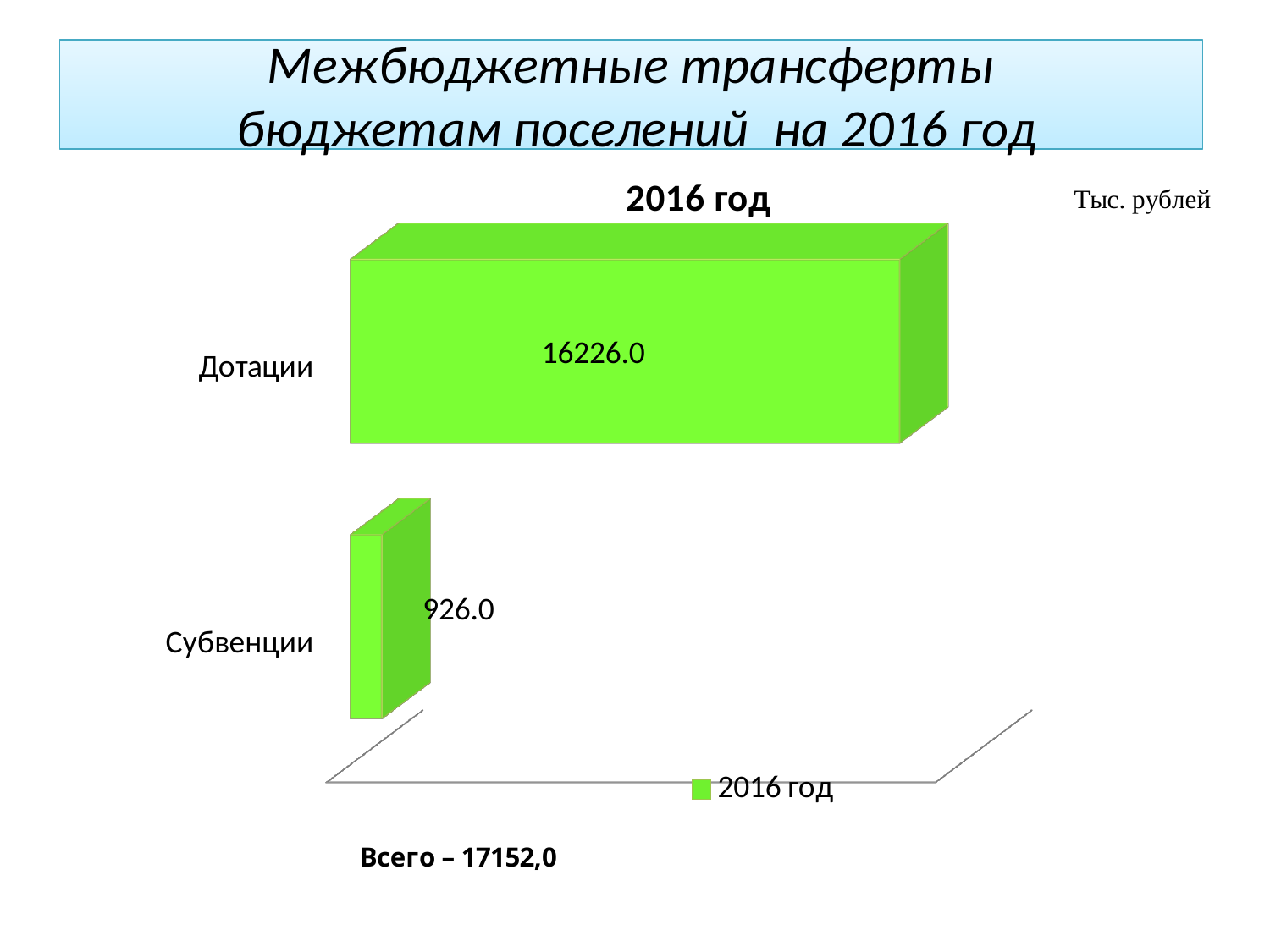
What is the value for Дотации? 16226.0 What is the total of the two categories shown in the chart? 17152.0 Which category has the lowest value? Субвенции What kind of chart is shown on the slide? bar chart What series name is shown in the legend? 2016 год What is the value for Субвенции? 926.0 Which is larger, the value for Дотации or the value for Субвенции? Дотации How many categories are shown in the chart? 2 What is the title of the chart? 2016 год What is the difference between the values for Дотации and Субвенции? 15300.0 How many series does the legend list? 1 Which category has the highest value? Дотации